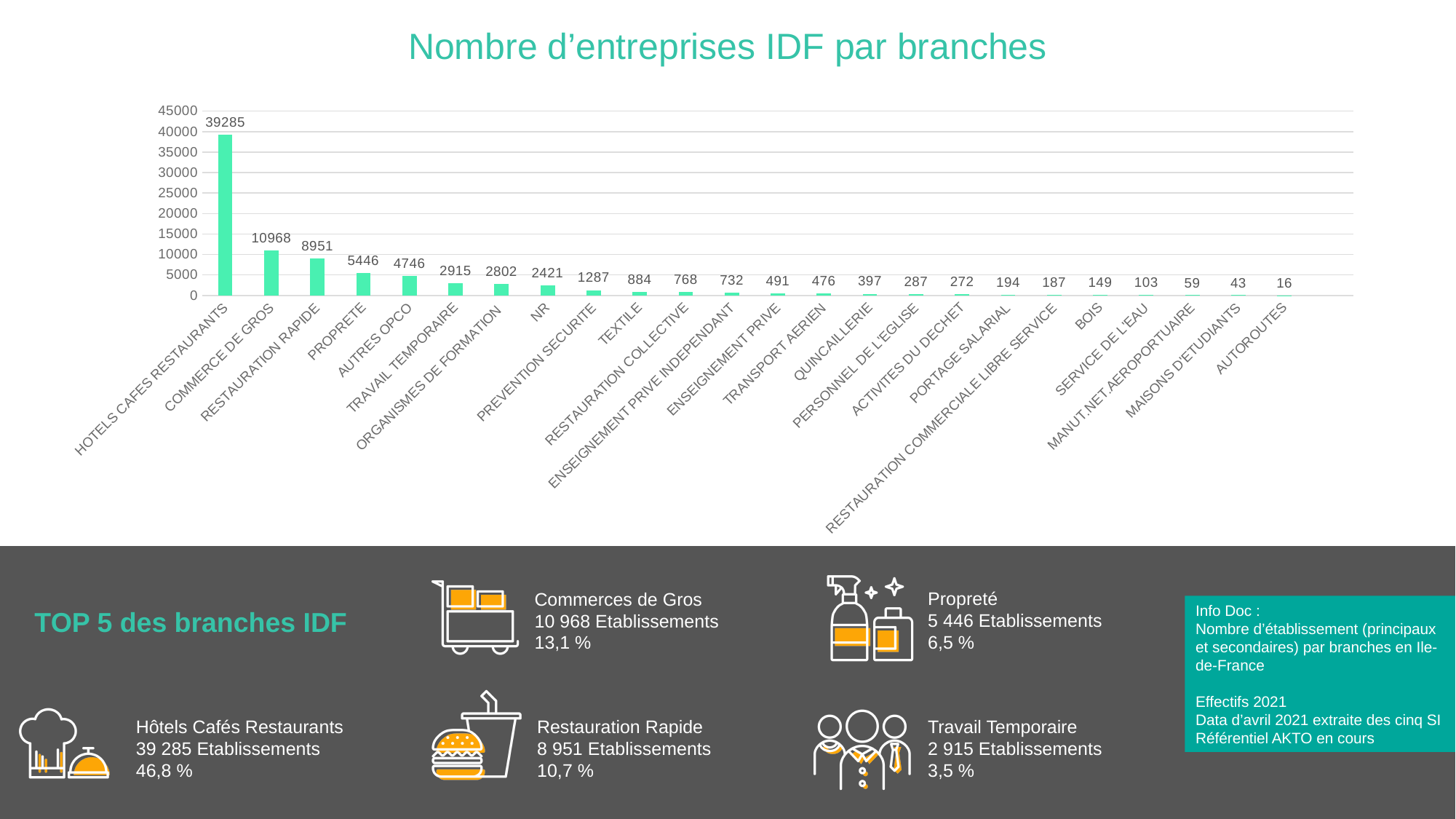
Which is larger, TRAVAIL TEMPORAIRE or ORGANISMES DE FORMATION? TRAVAIL TEMPORAIRE What is the difference between COMMERCE DE GROS and RESTAURATION RAPIDE? 2017 How many branches are shown on the x axis? 24 What is the value for PROPRETE? 5446 What is the value for AUTOROUTES? 16 What is the value for HOTELS CAFES RESTAURANTS? 39285 Which branch has the highest value? HOTELS CAFES RESTAURANTS Which branch has the lowest value? AUTOROUTES What is the difference between PROPRETE and AUTRES OPCO? 700 What type of chart is shown on the slide? bar chart What is the value for TEXTILE? 884 Do the values rise or fall from left to right along the x axis? fall